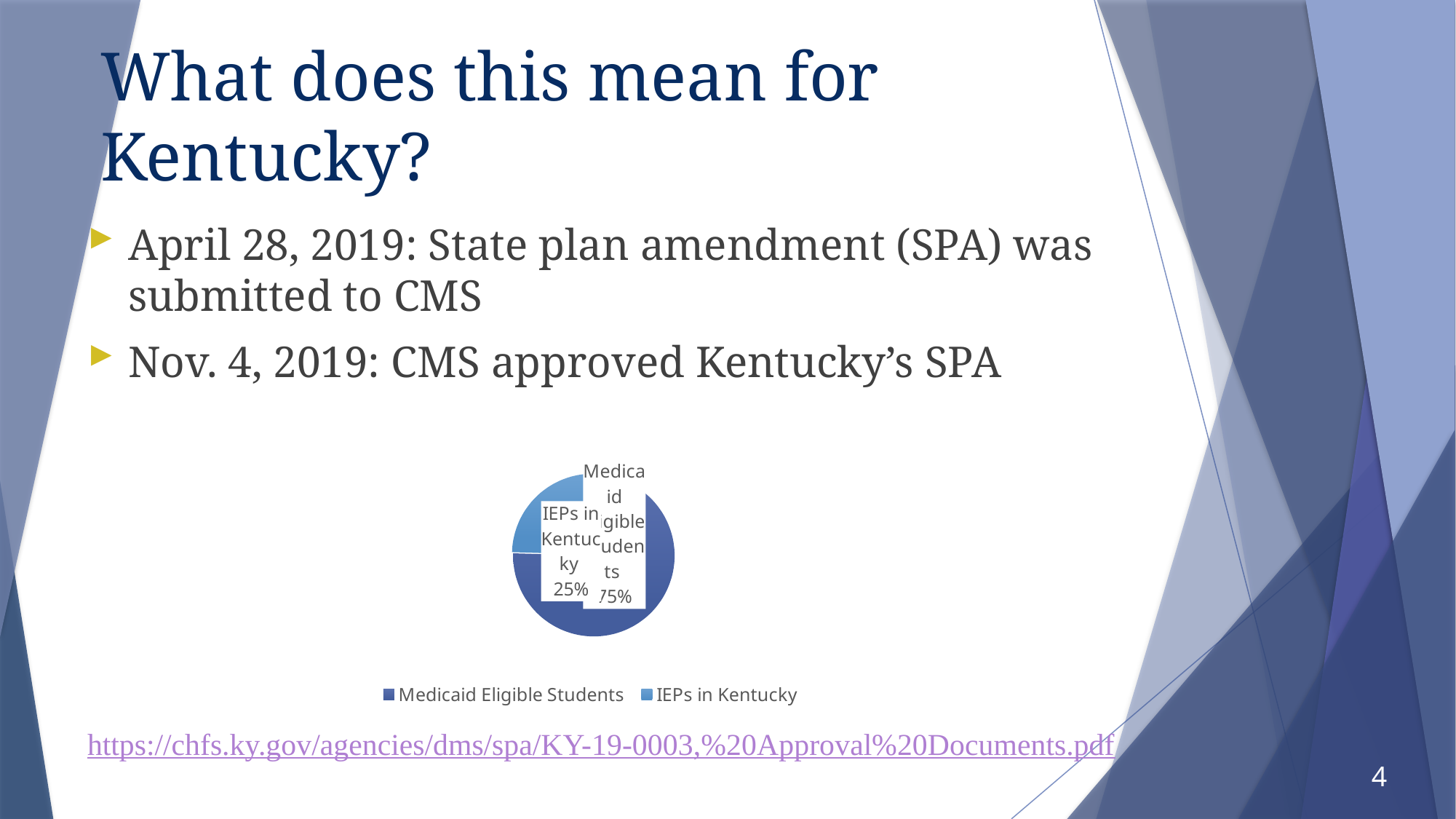
What share of the pie does IEPs in Kentucky represent? 25% What kind of chart is shown on the slide? pie chart Which legend entry is shown in the darker blue colour? Medicaid Eligible Students Which slice of the pie is the largest? Medicaid Eligible Students What share of the pie does Medicaid Eligible Students represent? 75% Which slice of the pie is the smallest? IEPs in Kentucky How many slices does the pie chart have? 2 How many entries does the chart legend list? 2 Which is larger, the Medicaid Eligible Students slice or the IEPs in Kentucky slice? Medicaid Eligible Students What is the difference in percentage points between the Medicaid Eligible Students slice and the IEPs in Kentucky slice? 50 Which legend entry is shown in the lighter blue colour? IEPs in Kentucky